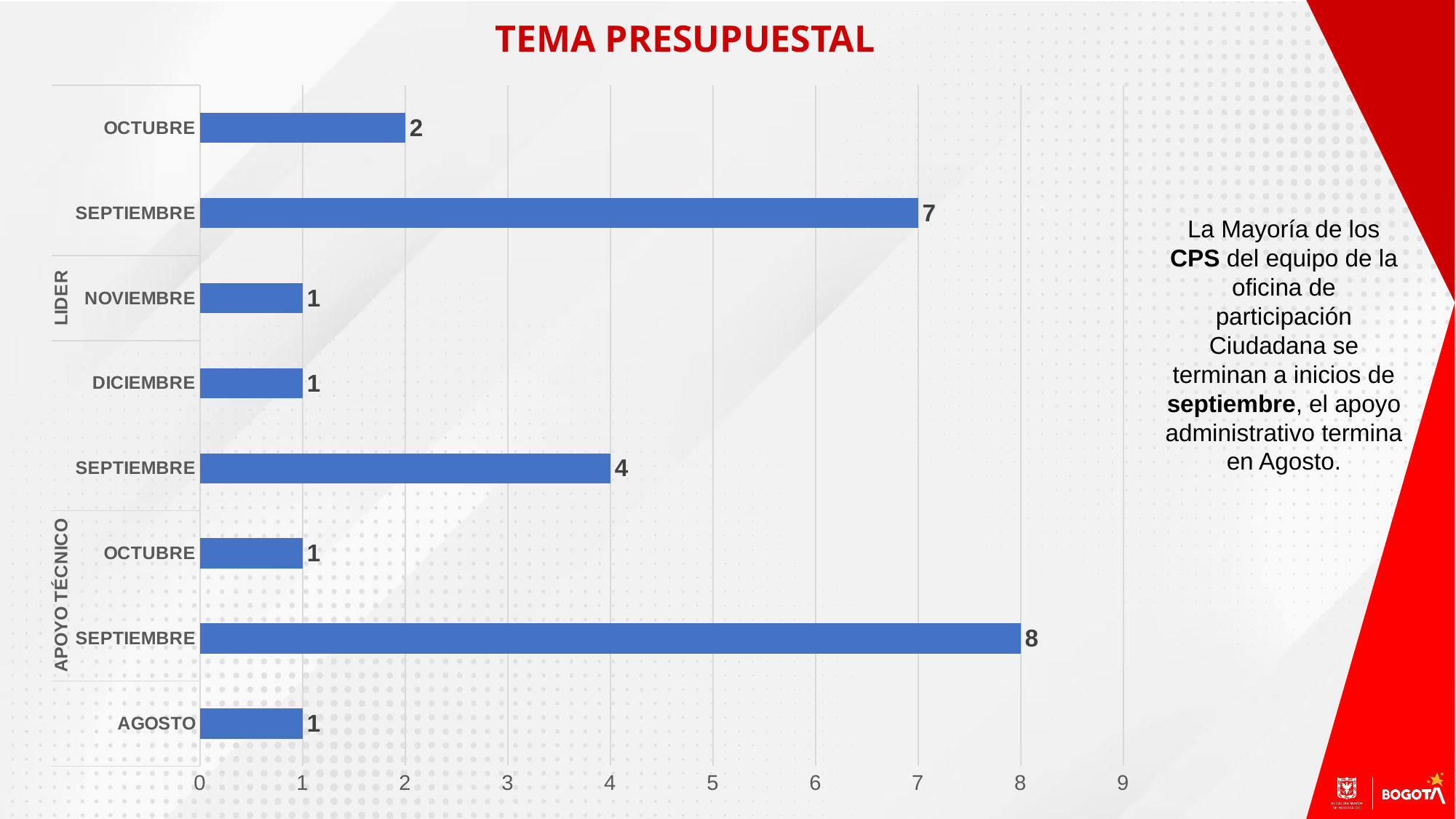
What is the value of the SEPTIEMBRE bar directly above AGOSTO? 8 How many bars are plotted in the chart? 8 What is the title of the slide above the chart? TEMA PRESUPUESTAL What is the value for NOVIEMBRE? 1 What is the value for AGOSTO, the bottom bar? 1 What is the value of the topmost bar, labelled OCTUBRE? 2 What is the value of the SEPTIEMBRE bar that is second from the top? 7 What is the difference between the SEPTIEMBRE bar directly above AGOSTO (8) and the SEPTIEMBRE bar second from the top (7)? 1 What is the value for DICIEMBRE? 1 What are the two group labels shown along the left side of the chart? LIDER and APOYO TÉCNICO Which bar has the highest value in the chart? SEPTIEMBRE (the bar directly above AGOSTO), 8 What kind of chart is shown on the slide? bar chart